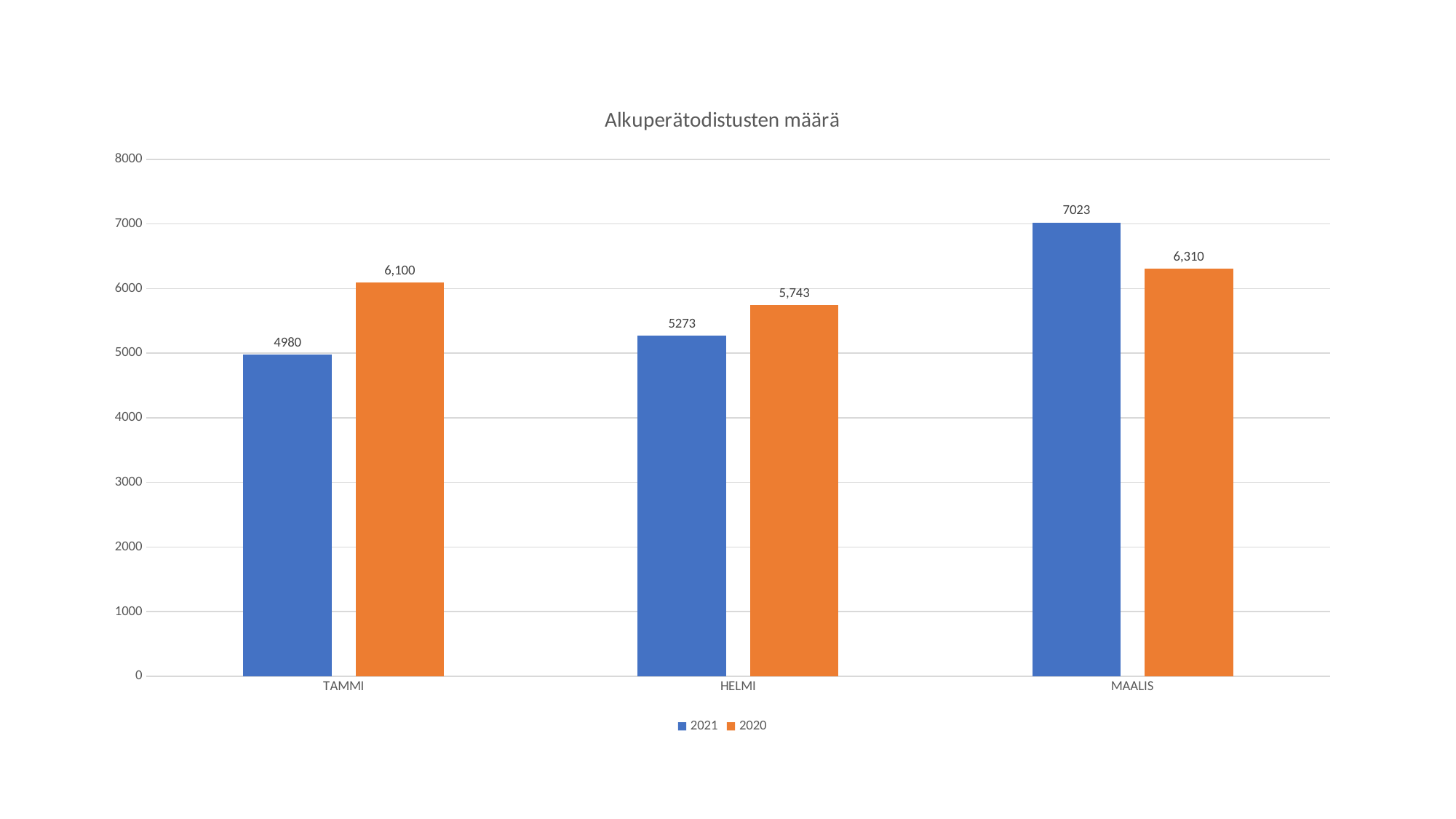
What is the value for 2021 in TAMMI? 4980 How many series does the legend list? 2 What is the value for 2020 in HELMI? 5,743 What is the value for 2020 in TAMMI? 6,100 What is the title of the chart? Alkuperätodistusten määrä What is the value for 2021 in MAALIS? 7023 Which category has the highest value for the 2021 series? MAALIS What kind of chart is shown on the slide? Bar chart What is the difference between the 2021 and 2020 values in MAALIS? 713 In HELMI, which series has the larger value, 2021 or 2020? 2020 Which category has the lowest value for the 2020 series? HELMI How many categories are shown on the x axis? 3